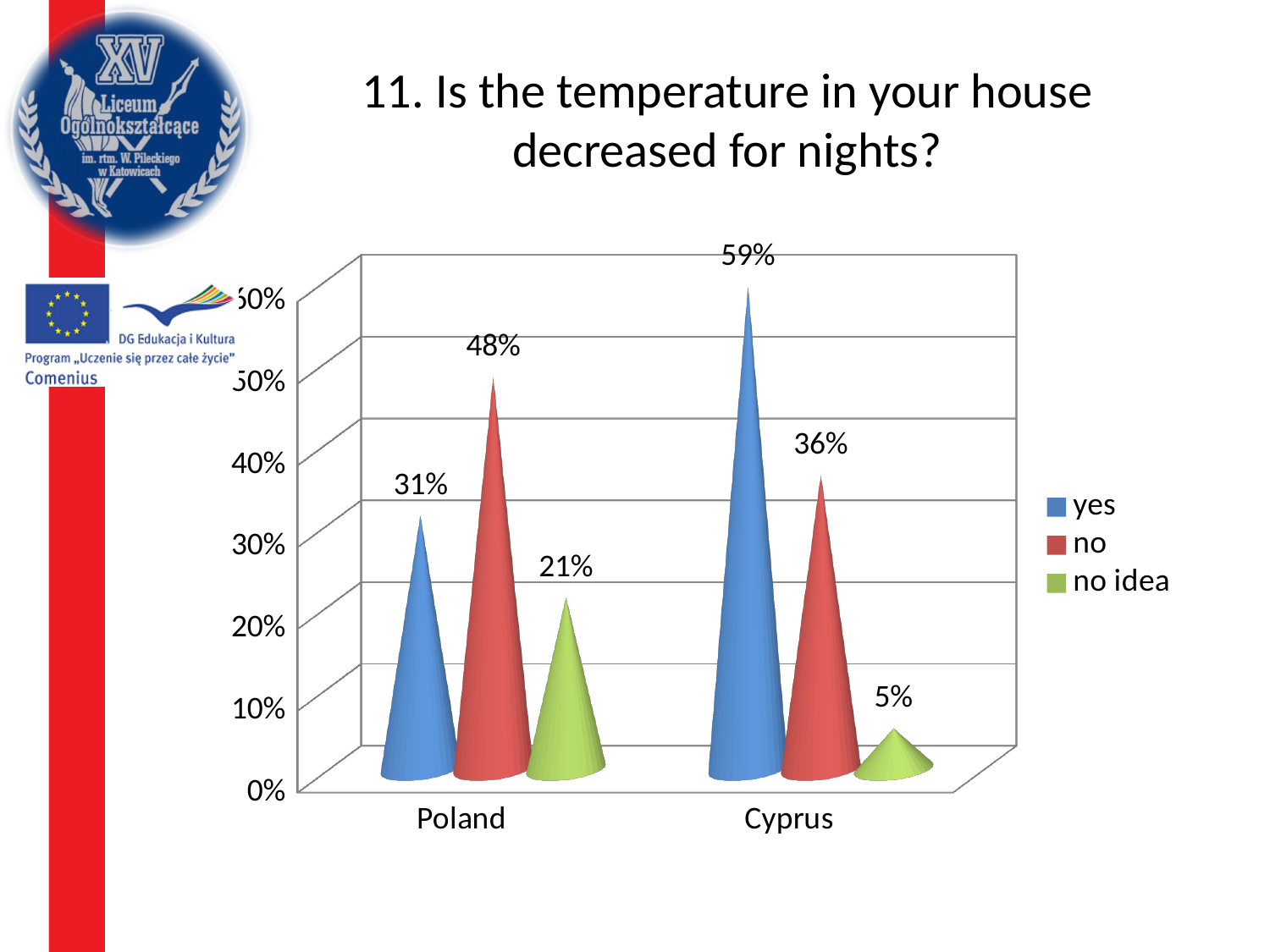
What is the difference between the "yes" percentages for Cyprus and Poland? 28% What percentage of respondents in Cyprus answered "yes"? 59% How many countries are shown on the x axis? 2 Which answer has the lowest percentage for Cyprus? no idea How many series does the legend list? 3 Which is larger: the "no" percentage for Poland or the "no" percentage for Cyprus? Poland What percentage of respondents in Cyprus answered "no"? 36% What colour represents the "no idea" series? green Which answer has the highest percentage for Poland? no What percentage of respondents in Poland answered "yes"? 31% What percentage of respondents in Poland answered "no idea"? 21% What is the difference between the "no idea" percentages for Poland and Cyprus? 16%